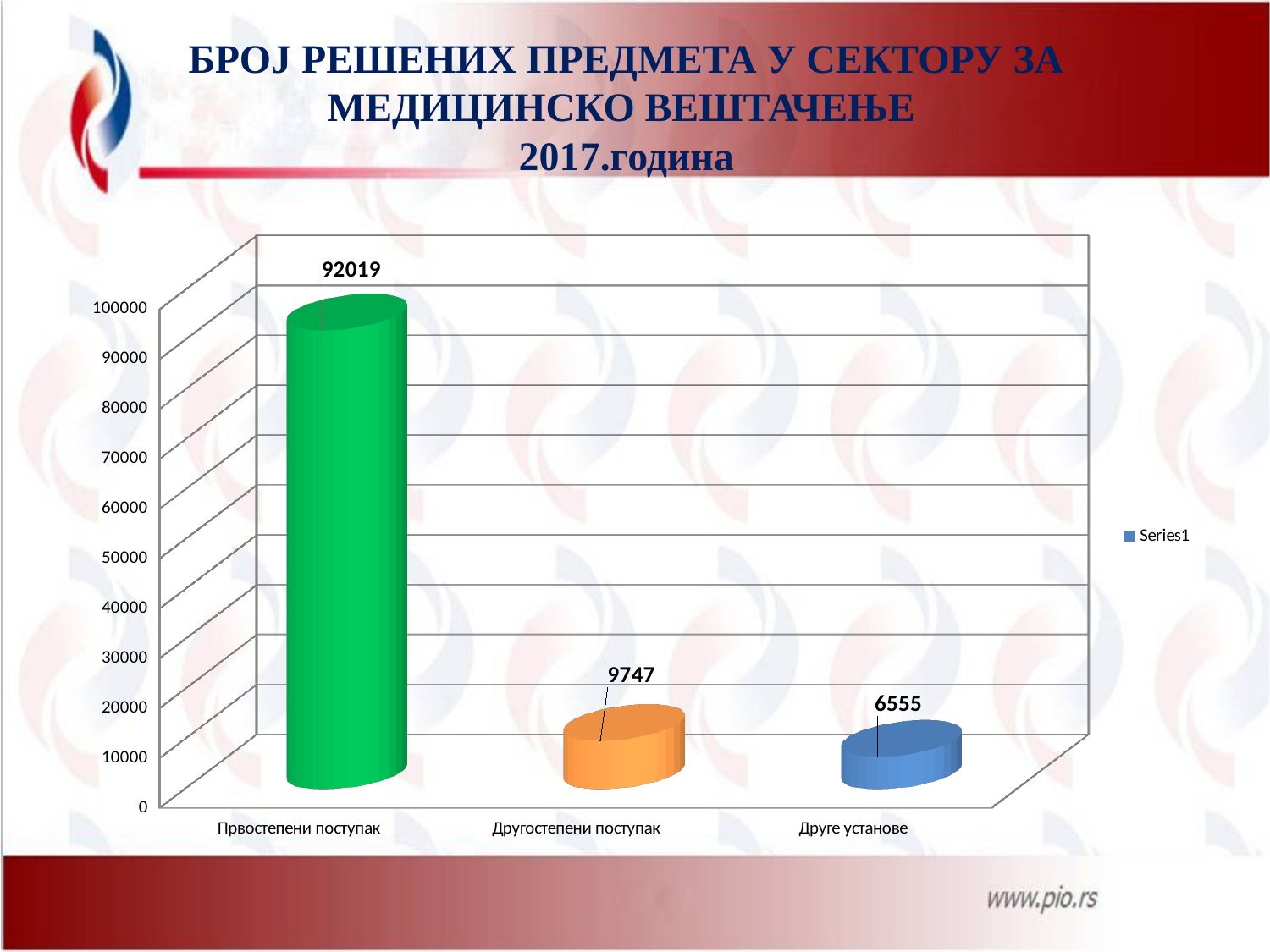
What is the only entry listed in the legend? Series1 What is the difference between the values for Другостепени поступак and Друге установе? 3192 What is the difference between the values for Првостепени поступак and Другостепени поступак? 82272 What is the value for Друге установе? 6555 What is the value for Првостепени поступак? 92019 Is the value for Првостепени поступак greater or less than 90000? greater Which category has the highest value? Првостепени поступак Which is larger, the value for Другостепени поступак or the value for Друге установе? Другостепени поступак What is the value for Другостепени поступак? 9747 Which category has the lowest value? Друге установе What kind of chart is shown on the slide? bar chart How many categories are shown on the x axis? 3